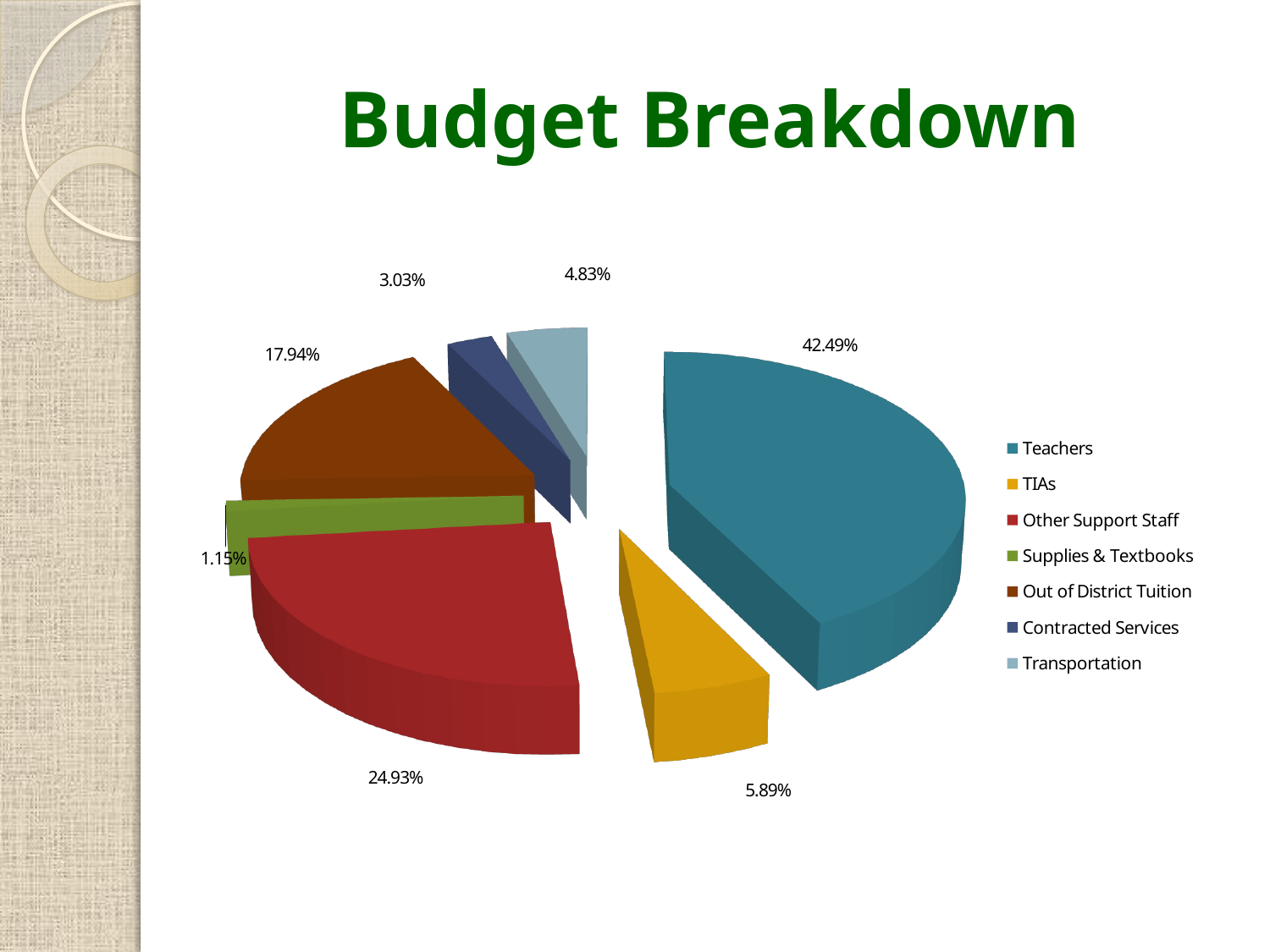
How many categories does the legend list? 7 Which has a larger share, Transportation or Contracted Services? Transportation What share of the budget goes to Supplies & Textbooks? 1.15% Which category has the largest share of the budget? Teachers What is the title of the chart? Budget Breakdown What share of the budget goes to Other Support Staff? 24.93% What share of the budget goes to Out of District Tuition? 17.94% Which category has the smallest share of the budget? Supplies & Textbooks What kind of chart is shown on the slide? Pie chart What is the difference between the Teachers share and the Other Support Staff share? 17.56%